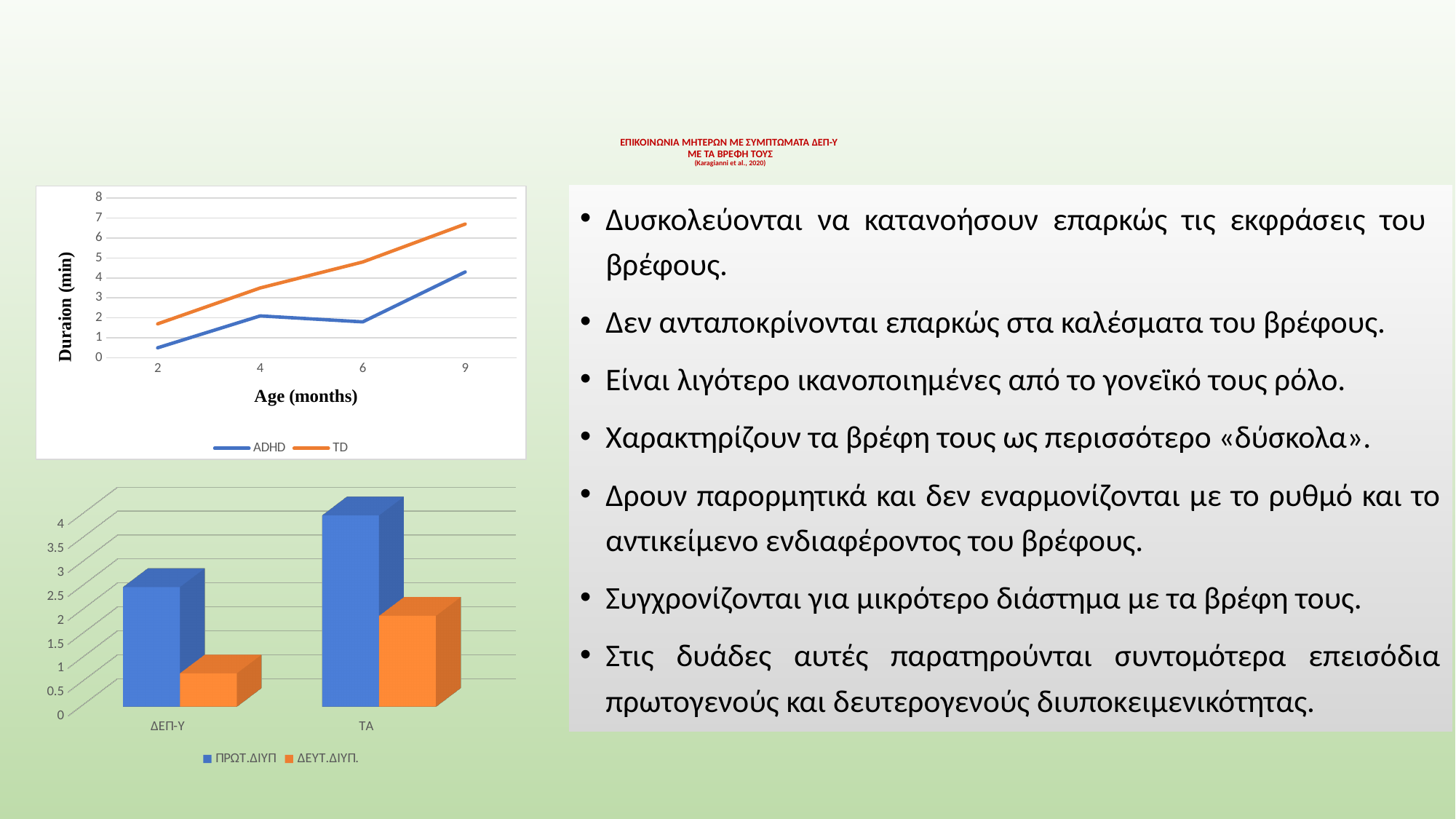
In the top line chart, does the TD line rise or fall as age increases? rises In the top line chart, is the TD value at 9 months greater or less than 6? greater In the top line chart, is the ADHD value at 2 months greater or less than 1? less What kind of chart is the bottom chart on the slide? bar chart What kind of chart is the top chart on the slide? line chart In the bottom bar chart, how many series does the legend list? 2 In the top line chart, how many series does the legend list? 2 In the bottom bar chart, is the ΔΕΥΤ.ΔΙΥΠ. value for ΔΕΠ-Υ greater or less than 1? less In the top line chart, how many age points are shown on the x axis? 4 What is the x-axis title of the top line chart? Age (months) In the bottom bar chart, which category has the higher ΠΡΩΤ.ΔΙΥΠ bar, ΔΕΠ-Υ or ΤΑ? ΤΑ In the top line chart, which series has the higher duration at 9 months, ADHD or TD? TD